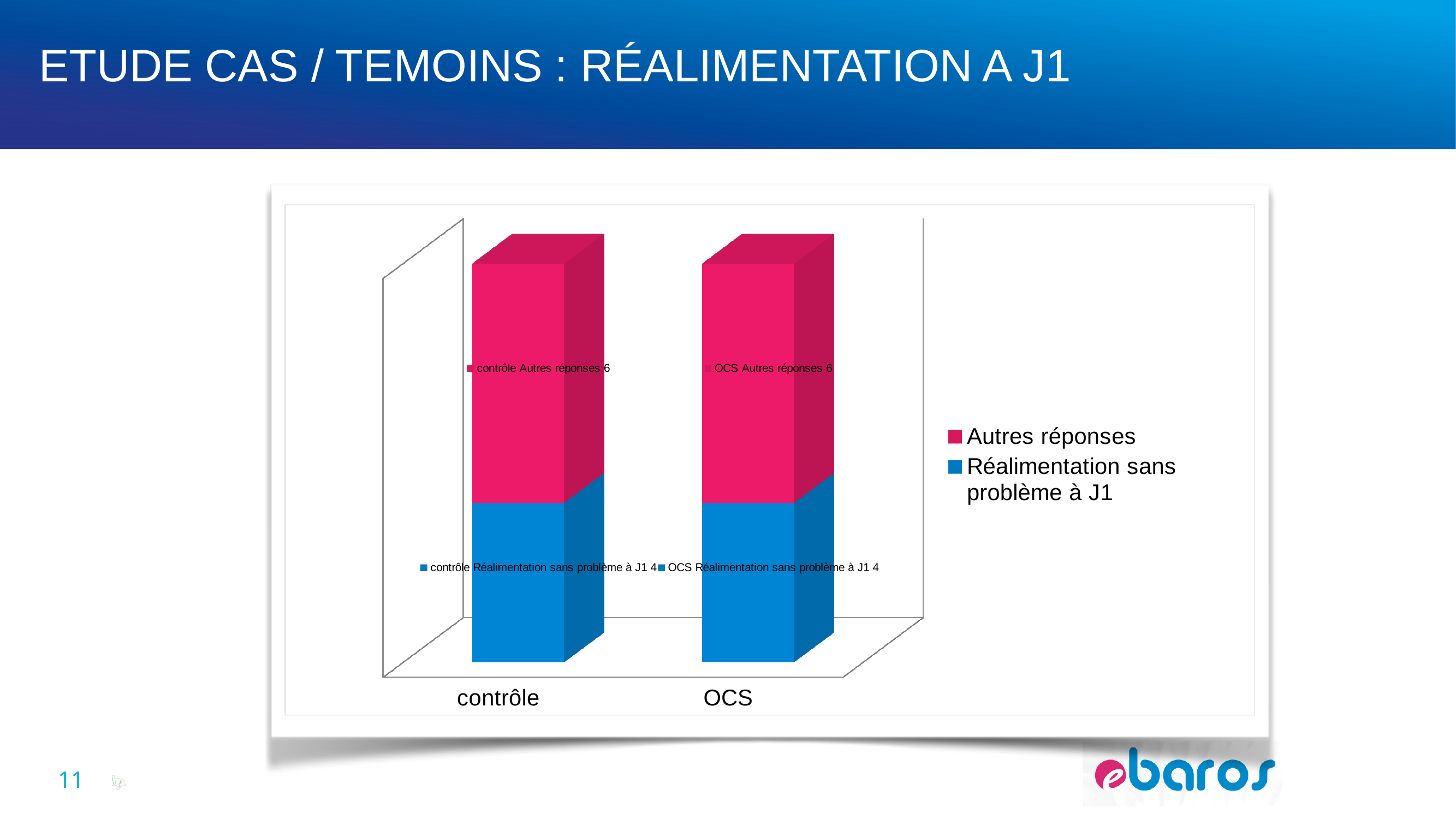
How many series does the legend list? 2 For contrôle, what is the difference between Autres réponses and Réalimentation sans problème à J1? 2 What is the total of the stacked bar for OCS? 10 For OCS, which is larger: Autres réponses or Réalimentation sans problème à J1? Autres réponses Which colour represents Autres réponses in the legend? Pink What is the total of the stacked bar for contrôle? 10 What is the value of Réalimentation sans problème à J1 for contrôle? 4 What is the value of Réalimentation sans problème à J1 for OCS? 4 How many categories are shown on the x axis? 2 What is the value of Autres réponses for OCS? 6 What kind of chart is shown on the slide? Stacked bar chart What is the value of Autres réponses for contrôle? 6